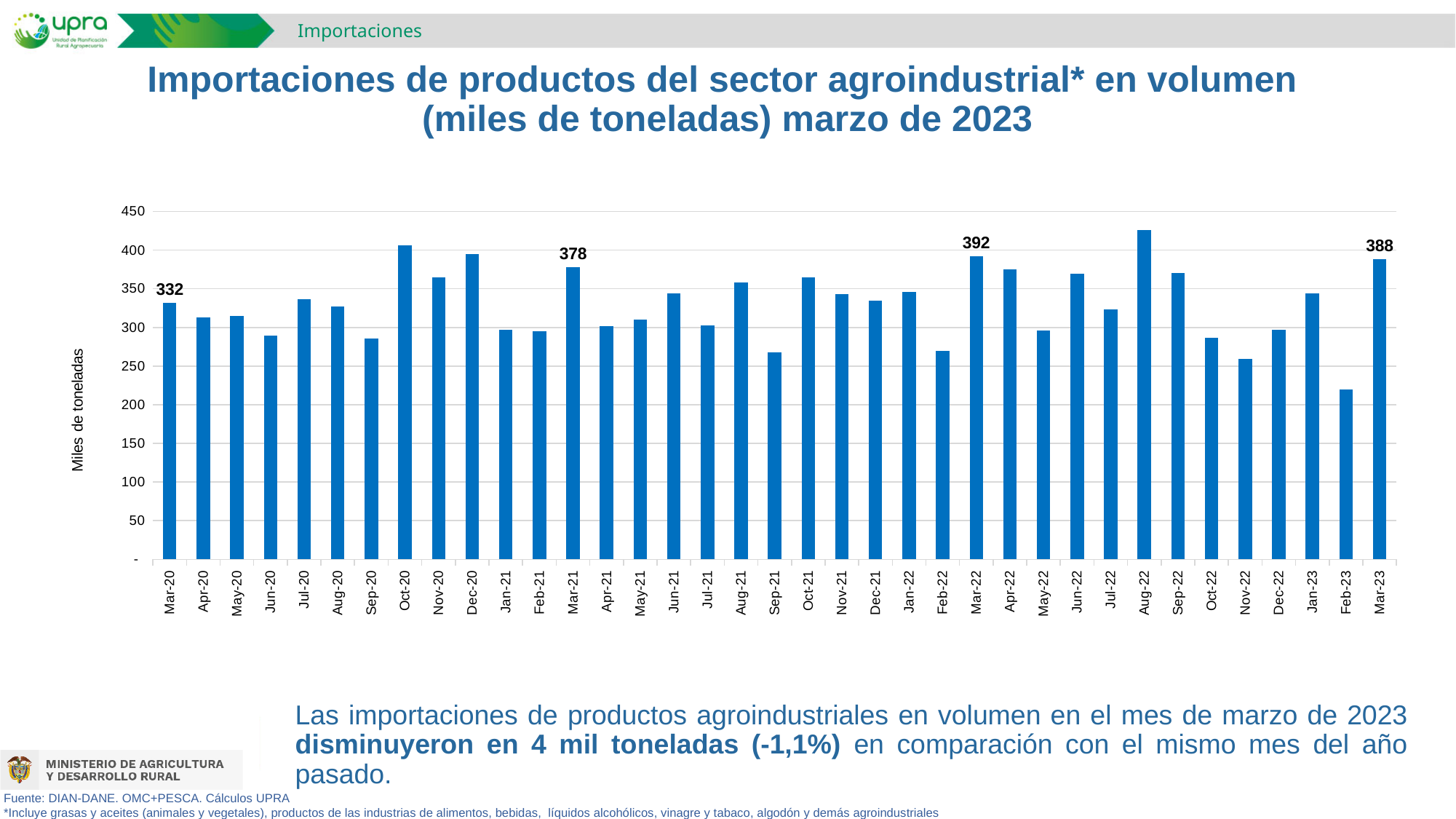
What is the value for Mar-22? 392 How many monthly bars are plotted in the chart? 37 Is the value for Feb-23 greater or less than 250? less Is the value for Oct-20 greater or less than 400? greater What is the difference between the values for Mar-22 and Mar-21? 14 What is the value for Mar-20? 332 Which month has the highest bar? Aug-22 What kind of chart is shown on the slide? Bar chart What is the value for Mar-23? 388 What is the difference between the values for Mar-23 and Mar-20? 56 Which is larger, the value for Mar-22 or the value for Mar-23? Mar-22 Which month has the lowest bar? Feb-23